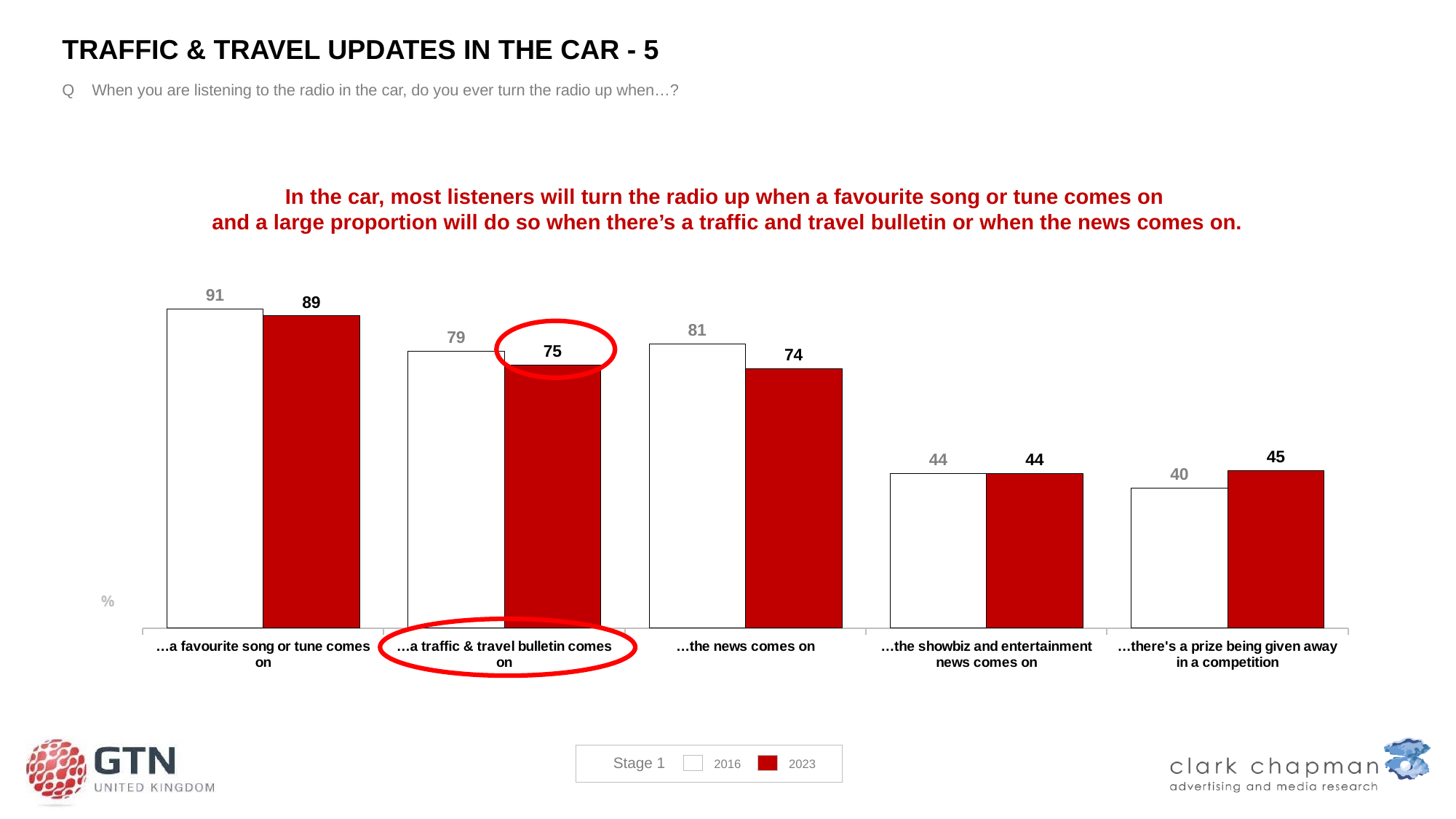
Which is larger for '…a favourite song or tune comes on': the 2016 value or the 2023 value? 2016 Which colour represents the 2023 series in the legend? Red Which category has the highest 2023 value? …a favourite song or tune comes on What is the 2023 value for '…there's a prize being given away in a competition'? 45 How many categories are shown on the x axis? 5 How many series does the legend list? 2 What kind of chart is shown on the slide? Bar chart What is the difference between the 2016 and 2023 values for '…the news comes on'? 7 Which category has the lowest 2016 value? …there's a prize being given away in a competition What is the 2016 value for '…the news comes on'? 81 What is the 2023 value for '…a traffic & travel bulletin comes on'? 75